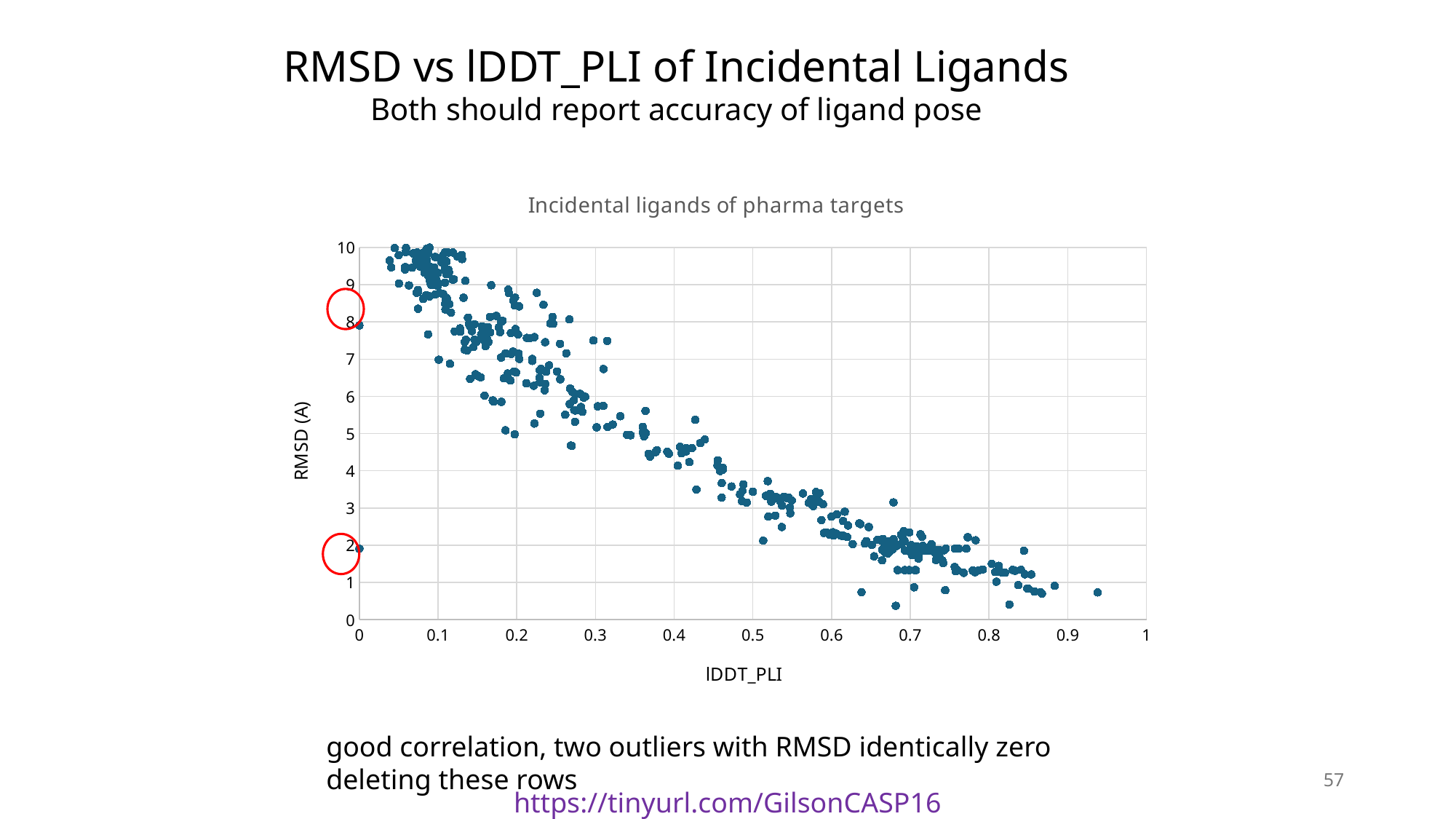
As lDDT_PLI increases along the x axis, does RMSD rise or fall? fall Are the RMSD values for points with lDDT_PLI near 0.05 greater or less than 8? greater Which has higher RMSD values: points with lDDT_PLI near 0.1 or points with lDDT_PLI near 0.8? points with lDDT_PLI near 0.1 Is the RMSD value for the point at lDDT_PLI of about 0.94 greater or less than 2? less What kind of chart is shown on the slide? scatter plot What is the maximum value shown on the y axis of the chart? 10 How many points are circled in red on the chart? 2 What is the label of the x axis of the chart? lDDT_PLI Is the RMSD value for the points at lDDT_PLI of 0.5 greater or less than 5? less What is the title of the chart? Incidental ligands of pharma targets